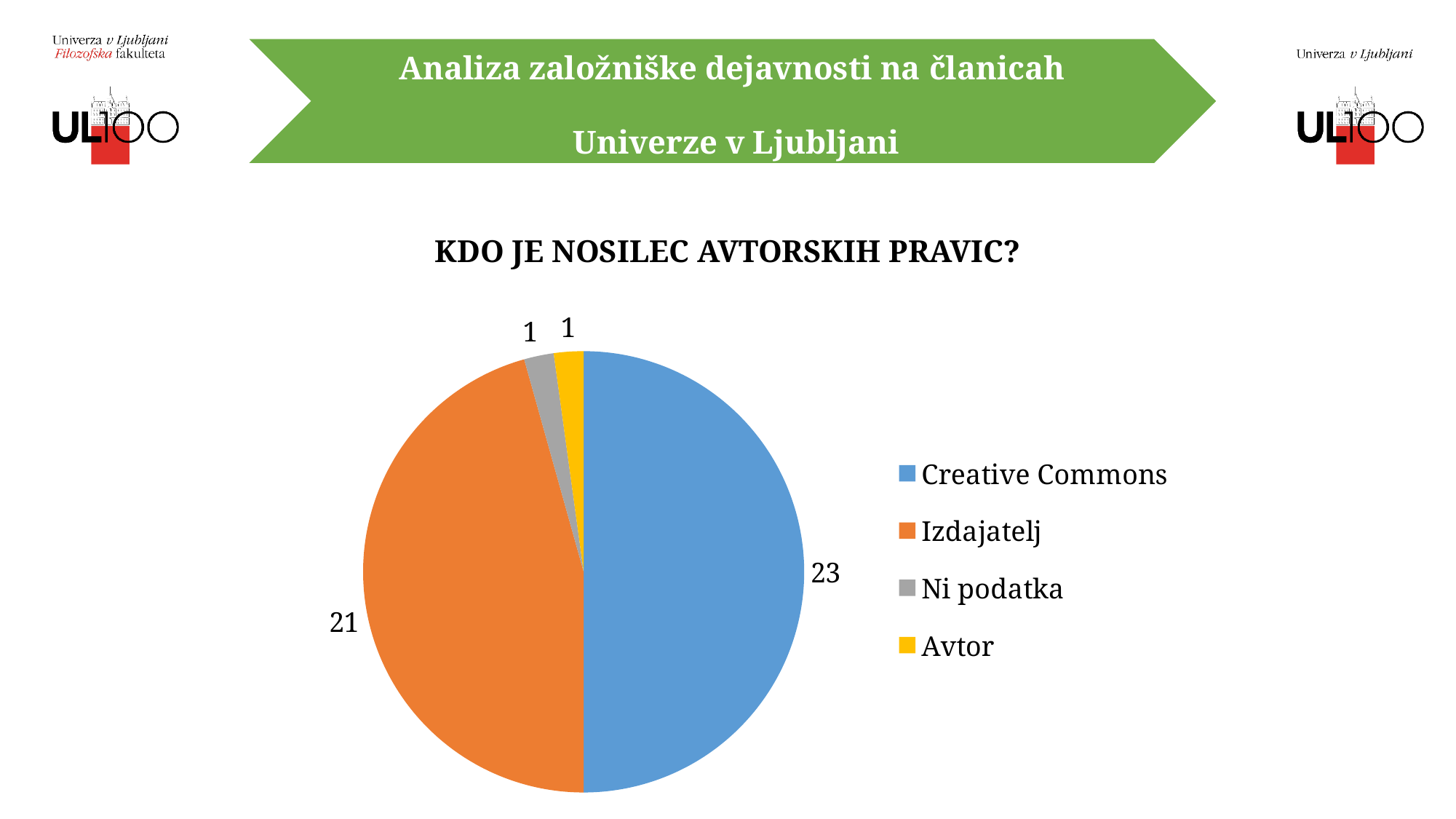
Which is larger, Izdajatelj or Creative Commons? Creative Commons What is the title of the chart? KDO JE NOSILEC AVTORSKIH PRAVIC? What is the value for Izdajatelj? 21 What is the value for Avtor? 1 What share of the pie does Creative Commons represent? 50% Which category has the largest slice? Creative Commons What is the value for Creative Commons? 23 What is the value for Ni podatka? 1 How many categories does the legend list? 4 What type of chart is shown on the slide? pie chart What is the difference between the values for Creative Commons and Izdajatelj? 2 What is the total of all slices in the pie? 46